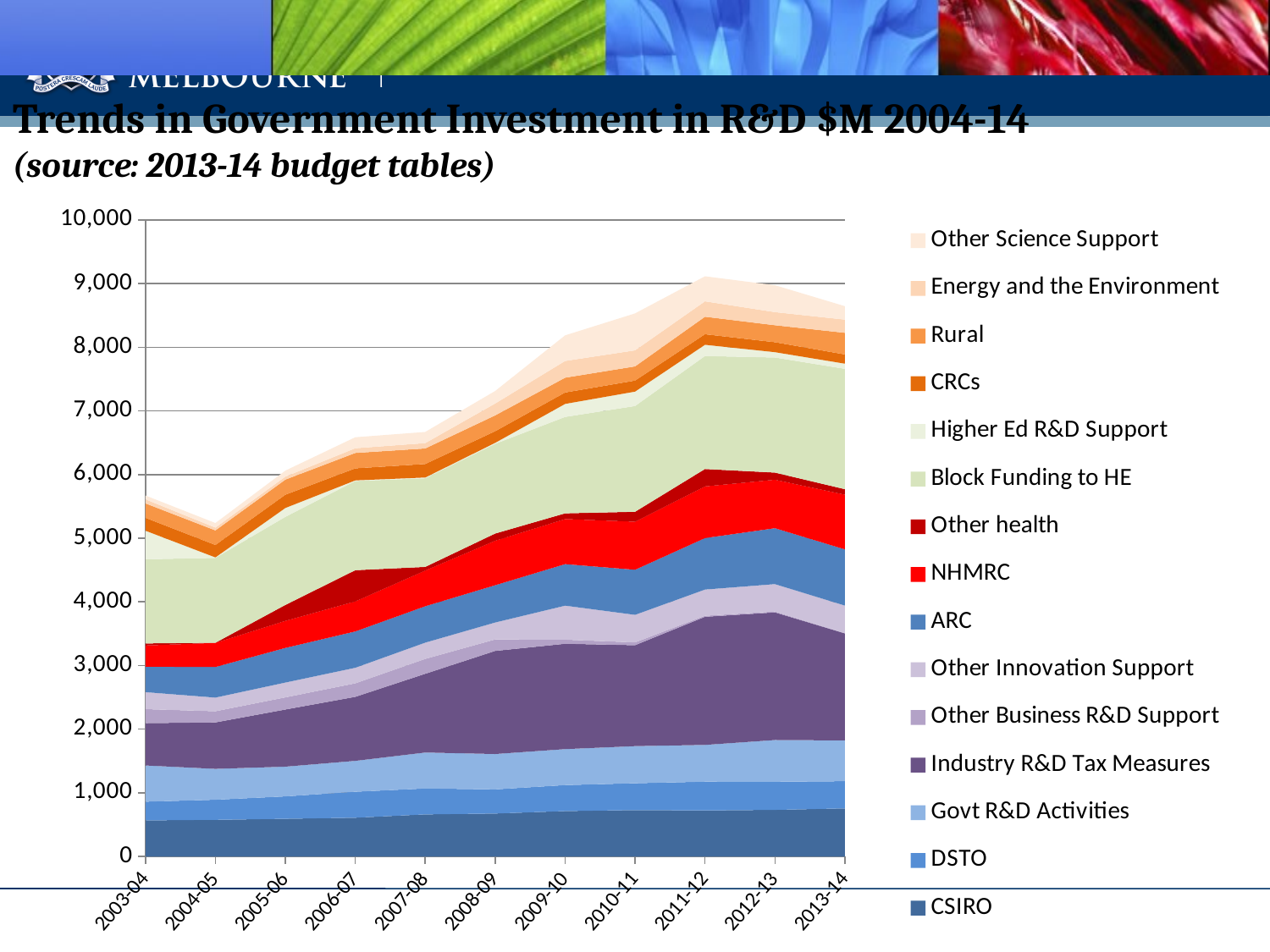
Does the total investment rise or fall from 2004-05 to 2011-12? rise How many years are shown along the x axis? 11 What kind of chart is shown on the slide? Stacked area chart Is the total investment in 2013-14 greater or less than 9,000? less Which series is plotted at the bottom of the stack? CSIRO Is the total investment in 2003-04 greater or less than 5,000? greater How many series does the legend list? 15 In which year is the total government investment in R&D highest? 2011-12 What is the highest value shown on the y axis? 10,000 Is the total investment in 2009-10 greater or less than 7,000? greater In which year is the total government investment in R&D lowest? 2004-05